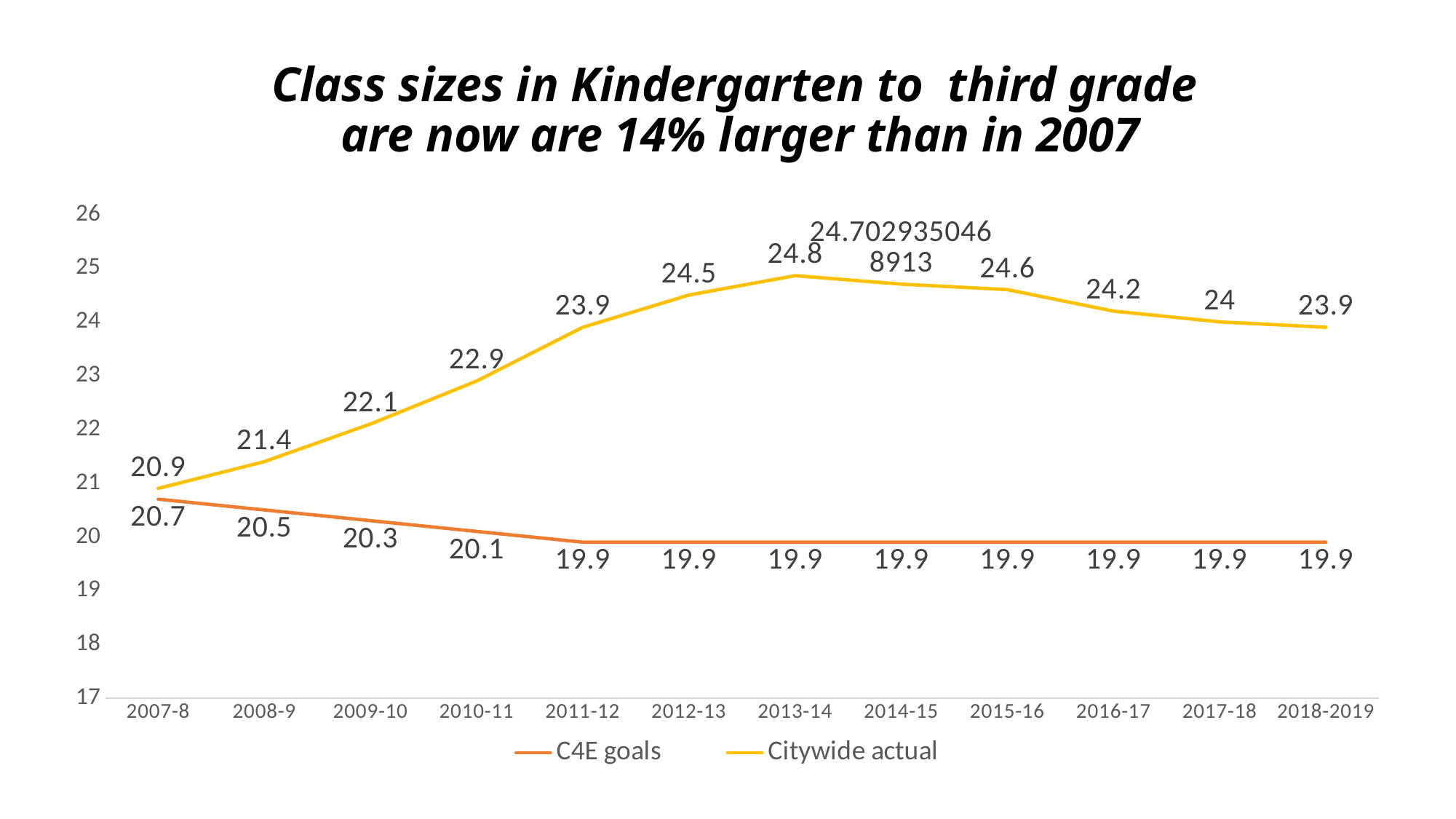
How many series does the legend list? 2 Does the C4E goals series rise or fall from 2007-8 to 2011-12? fall In which school year is the Citywide actual value lowest? 2007-8 What is the difference between the Citywide actual value and the C4E goals value in 2015-16? 4.7 What type of chart is shown on the slide? line chart How many school years are plotted along the x axis? 12 What is the Citywide actual class size for 2012-13? 24.5 In which school year does the Citywide actual series reach its highest value? 2013-14 What is the Citywide actual value for 2018-2019? 23.9 What colour is the line for the Citywide actual series? yellow Which series has the larger value in 2010-11, C4E goals or Citywide actual? Citywide actual What is the C4E goals value for 2009-10? 20.3